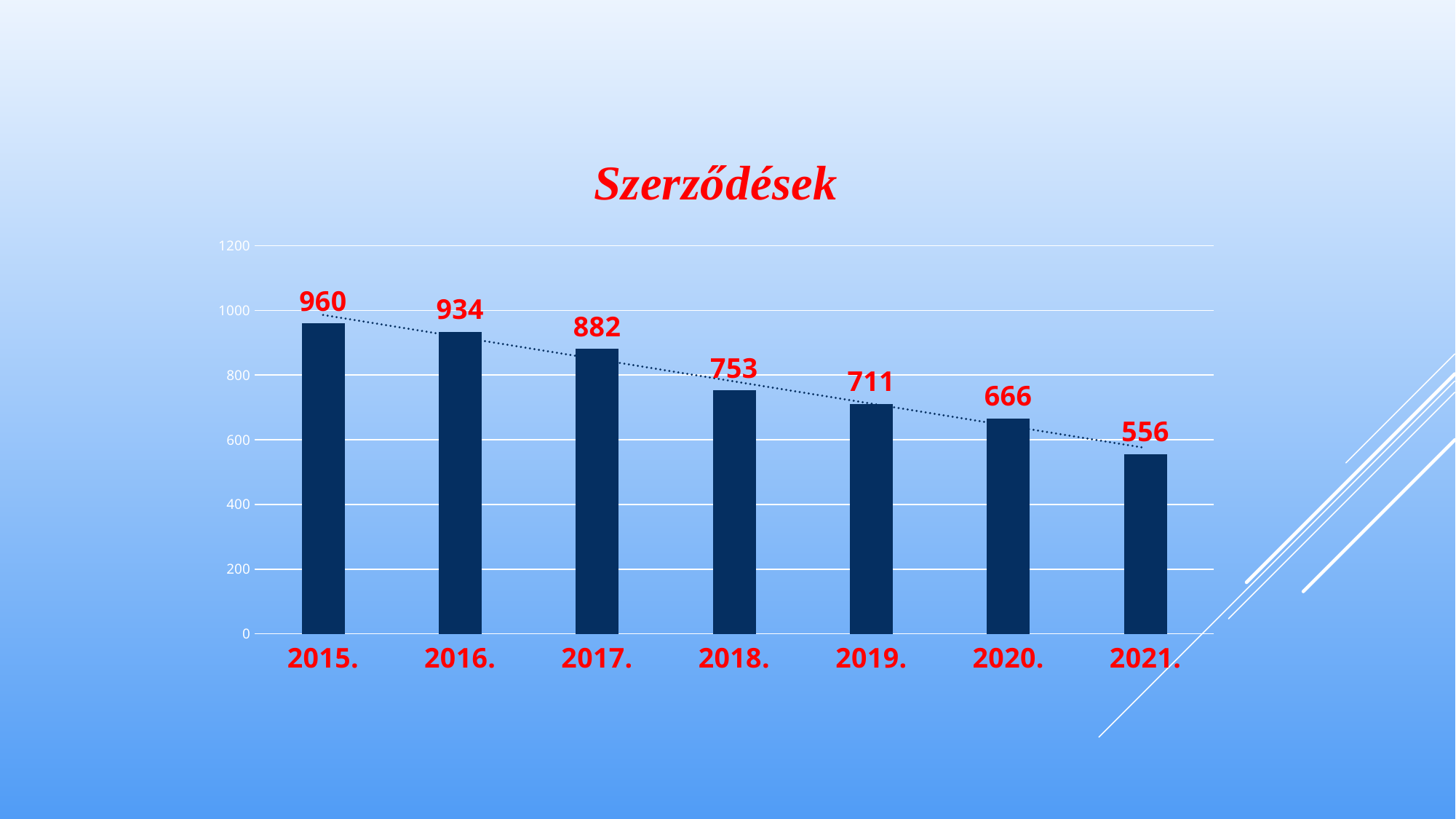
Which year has the highest value in the Szerződések chart? 2015. Is the value for 2016. greater or less than 800? greater Which year has the lowest value in the Szerződések chart? 2021. What is the value for 2021. in the Szerződések chart? 556 Which is larger, the value for 2019. or the value for 2020.? 2019. What is the difference between the values for 2015. and 2021.? 404 What is the value for 2018. in the Szerződések chart? 753 How many years are shown in the Szerződések chart? 7 What is the value for 2015. in the Szerződések chart? 960 What is the difference between the values for 2017. and 2018.? 129 What kind of chart is shown on the slide? bar chart Do the values rise or fall from 2015. to 2021.? fall